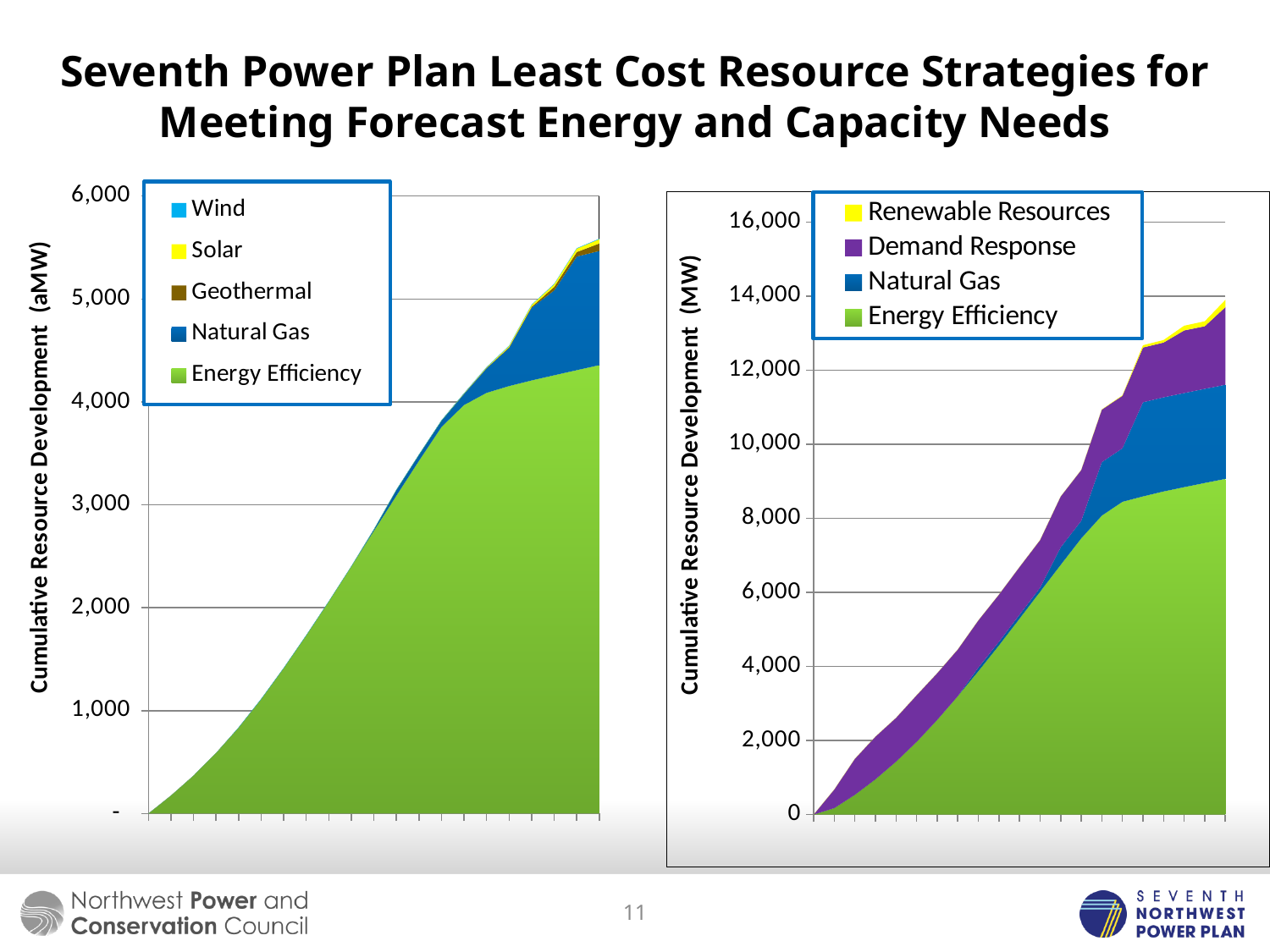
In the left chart, which series accounts for the largest share of the cumulative total? Energy Efficiency How many series does the legend of the right chart list? 4 What kind of chart is the left chart on the slide? Stacked area chart What is the y-axis title of the right chart? Cumulative Resource Development (MW) What kind of chart is the right chart on the slide? Stacked area chart In the right chart, do the cumulative values rise or fall along the x axis? Rise In the right chart, is the Energy Efficiency value at the right end of the chart greater or less than 10,000? less In the left chart, is the stacked total at the right end of the chart greater or less than 5,000? greater In the right chart, is the stacked total at the right end of the chart greater or less than 12,000? greater In the left chart, do the cumulative values rise or fall along the x axis? Rise Which series in the right chart's legend is shown in purple? Demand Response How many series does the legend of the left chart list? 5